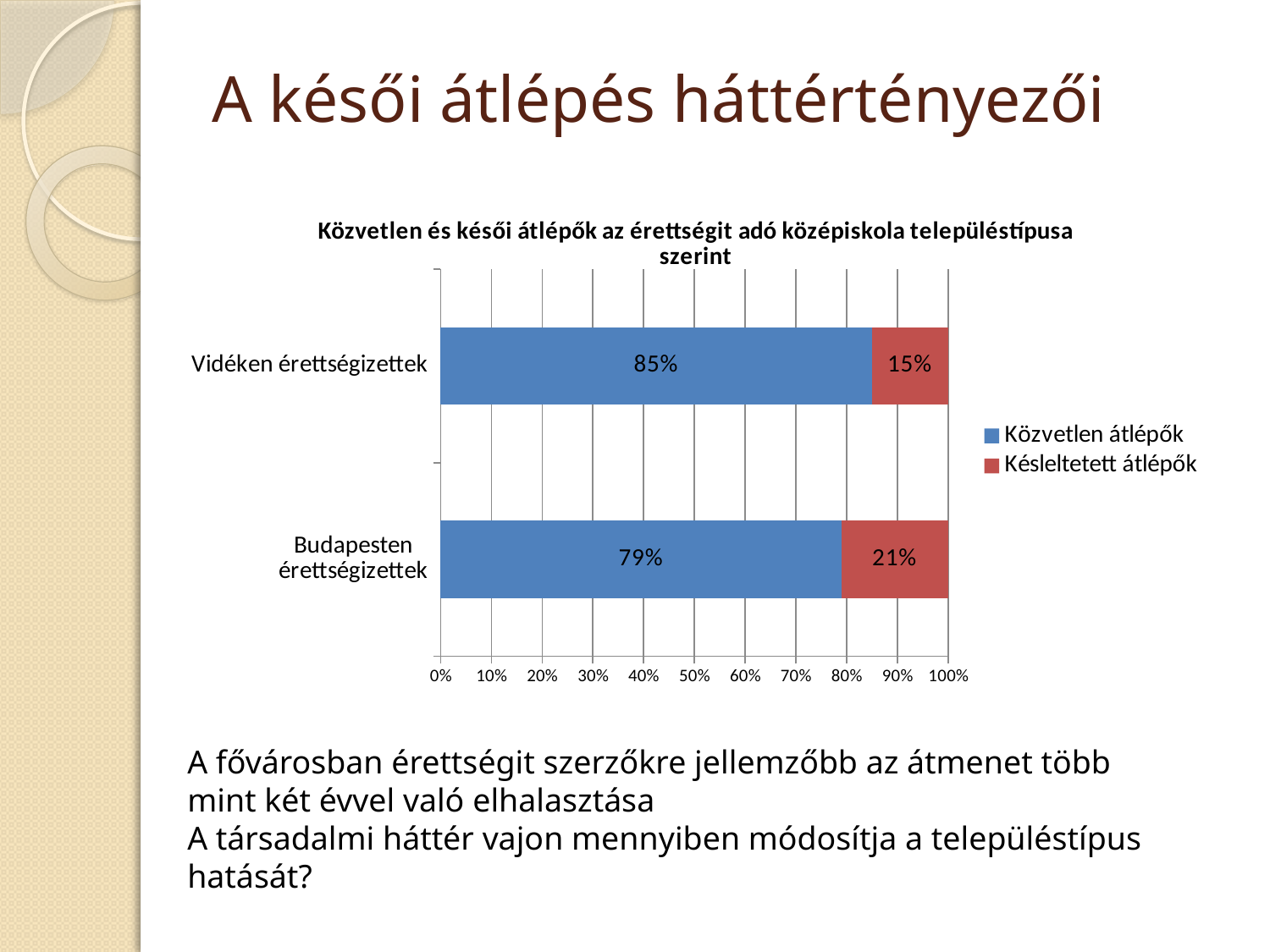
How many categories are shown on the chart? 2 What percentage of Budapesten érettségizettek are Közvetlen átlépők? 79% What type of chart is shown on the slide? Stacked bar chart What percentage of Budapesten érettségizettek are Késleltetett átlépők? 21% How many series does the legend list? 2 Is the Közvetlen átlépők share larger for Vidéken érettségizettek or Budapesten érettségizettek? Vidéken érettségizettek What colour represents Késleltetett átlépők in the chart? Red Which category has the lower share of Közvetlen átlépők? Budapesten érettségizettek What percentage of Vidéken érettségizettek are Késleltetett átlépők? 15% What percentage of Vidéken érettségizettek are Közvetlen átlépők? 85% What is the difference in the Közvetlen átlépők share between Vidéken érettségizettek and Budapesten érettségizettek? 6% Which category has the higher share of Késleltetett átlépők? Budapesten érettségizettek